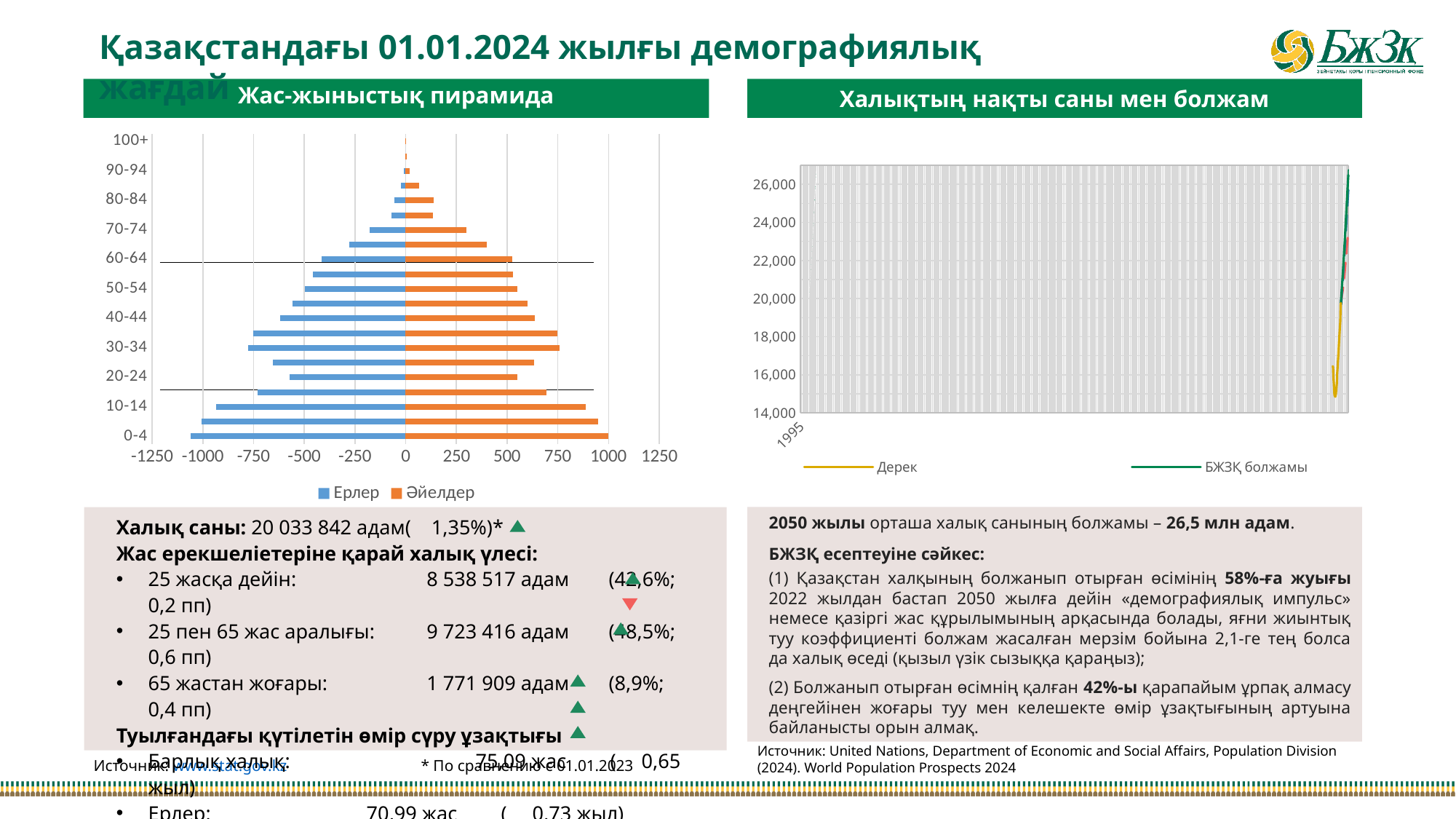
In the "Жас-жыныстық пирамида" chart, is the Әйелдер value for the 80-84 age group greater or less than 250? less What type of chart is the "Халықтың нақты саны мен болжам" chart? line chart In the "Жас-жыныстық пирамида" chart, for the 60-64 age group, which series has the longer bar, Ерлер or Әйелдер? Әйелдер What type of chart is the "Жас-жыныстық пирамида" chart? bar chart How many series does the legend of the "Халықтың нақты саны мен болжам" chart list? 2 In the "Жас-жыныстық пирамида" chart, which age group has the longest Әйелдер bar? 0-4 In the "Жас-жыныстық пирамида" chart, what is the highest value shown on the horizontal axis? 1250 In the "Халықтың нақты саны мен болжам" chart, is the final value of the БЖЗҚ болжамы line greater or less than 24,000? greater In the "Жас-жыныстық пирамида" chart, which series is shown in orange? Әйелдер In the "Жас-жыныстық пирамида" chart, is the Әйелдер value for the 0-4 age group greater or less than 750? greater In the "Халықтың нақты саны мен болжам" chart, does the БЖЗҚ болжамы line rise or fall along the x axis? rise How many series does the legend of the "Жас-жыныстық пирамида" chart list? 2